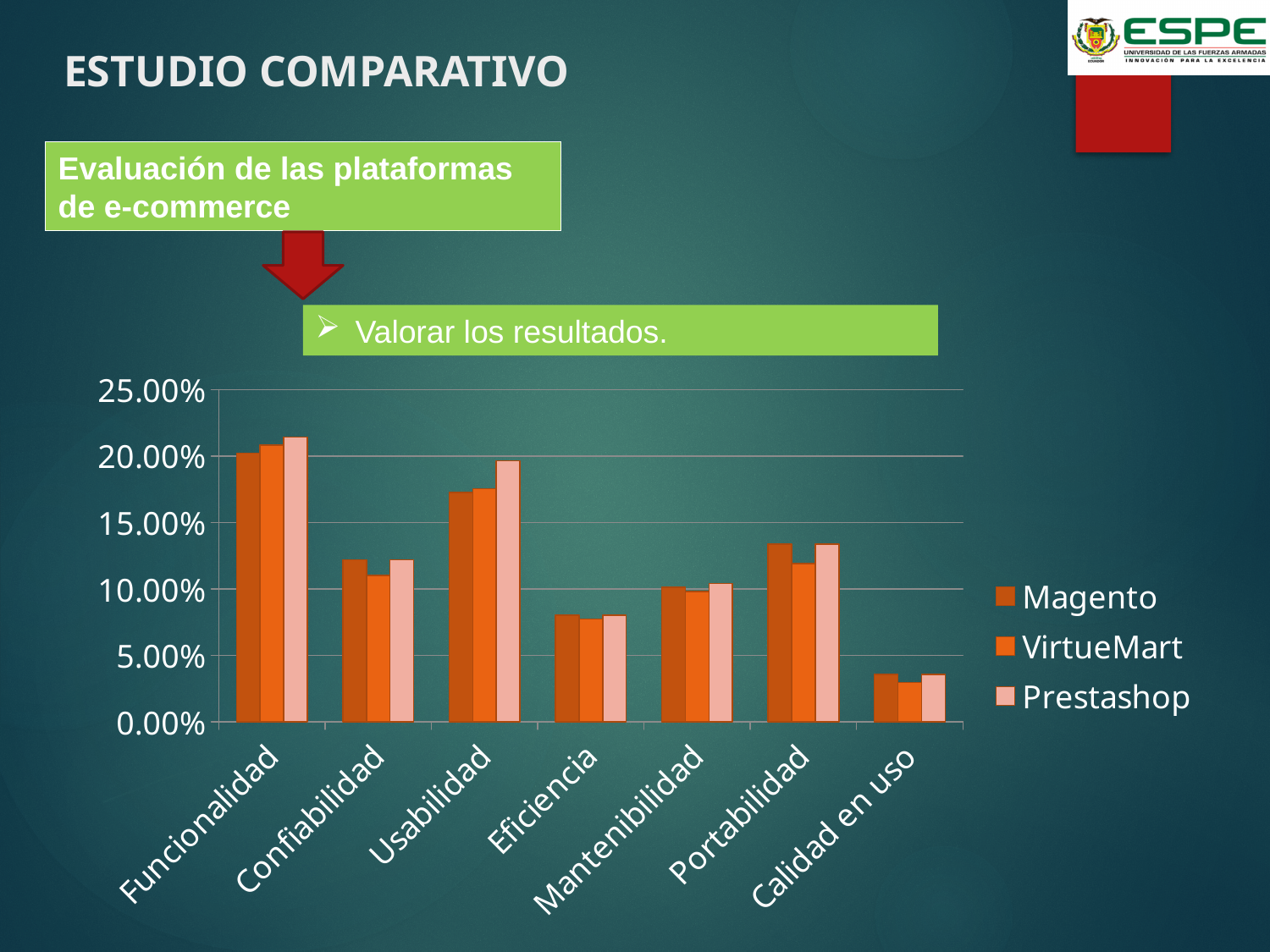
Is the Magento value for Usabilidad greater or less than 20.00%? less Is the Prestashop value for Funcionalidad greater or less than 20.00%? greater For which category is the Prestashop value highest? Funcionalidad Is the Prestashop value for Calidad en uso greater or less than 5.00%? less For Usabilidad, which is larger: the Magento value or the Prestashop value? Prestashop For Confiabilidad, which is larger: the Magento value or the VirtueMart value? Magento How many categories are shown on the x axis of the chart? 7 What kind of chart is shown on the slide? bar chart Which series are listed in the chart's legend? Magento, VirtueMart, Prestashop How many series does the chart's legend list? 3 For which category is the Magento value lowest? Calidad en uso